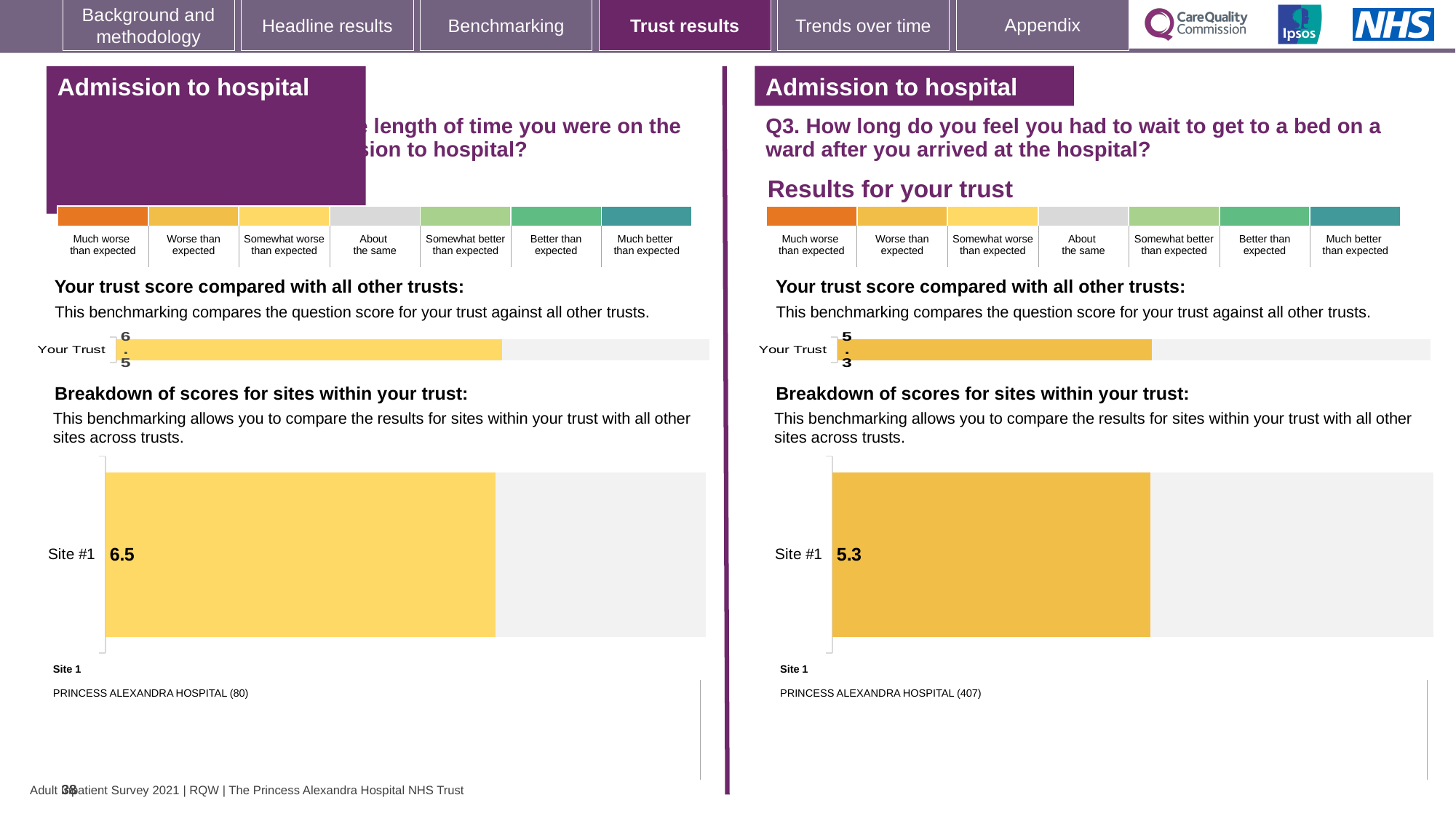
On the right-hand side of the slide (Q3), what is the 'Your Trust' score in the trust score comparison chart? 5.3 How many sites are shown in the breakdown of scores for sites chart on the left-hand side of the slide? 1 On the left-hand side of the slide, what is the 'Your Trust' score in the trust score comparison chart? 6.5 Which Site #1 score is larger: the one on the left-hand side of the slide or the one on the right-hand side (Q3)? Left-hand side (6.5) Which site name is listed under the Site #1 chart on the right-hand side of the slide (Q3)? PRINCESS ALEXANDRA HOSPITAL (407) What kind of chart is used to show the Site #1 score on the right-hand side of the slide (Q3)? Bar chart On the left-hand side of the slide, what is the score shown for Site #1 in the breakdown of scores for sites chart? 6.5 On the right-hand side of the slide (Q3, wait to get to a bed on a ward), what is the score shown for Site #1? 5.3 Is the Site #1 score on the right-hand side of the slide (Q3) greater or less than the Site #1 score on the left-hand side? less How many sites are shown in the breakdown of scores for sites chart on the right-hand side of the slide (Q3)? 1 What is the difference between the Site #1 score on the left-hand side of the slide and the Site #1 score on the right-hand side (Q3)? 1.2 Which site name is listed under the Site #1 chart on the left-hand side of the slide? PRINCESS ALEXANDRA HOSPITAL (80)